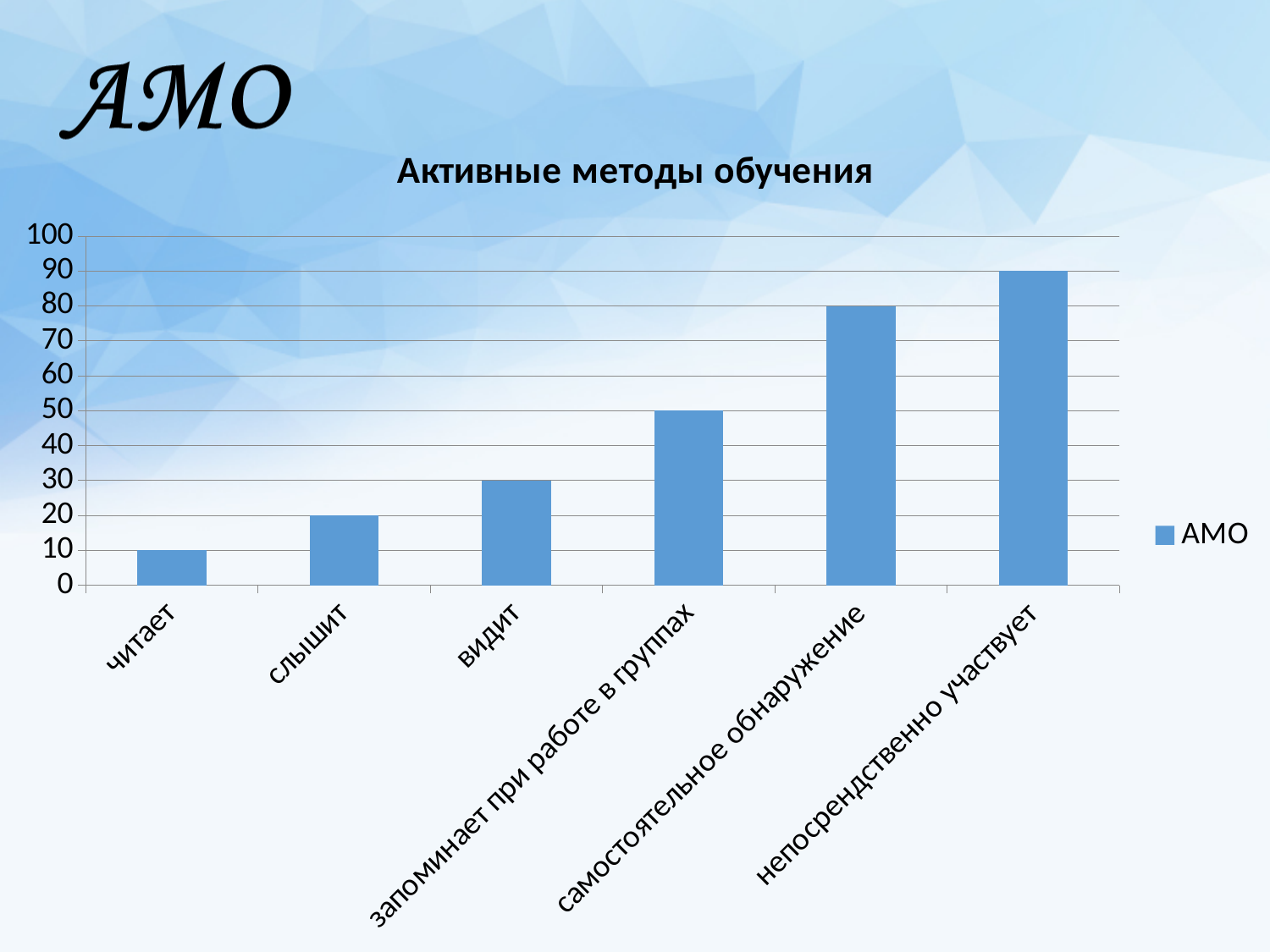
Which category has the highest value? непосрендственно участвует What is the value for "видит"? 30 Do the values rise or fall from left to right along the x axis? rise How many series does the legend list? 1 What is the title of the chart? Активные методы обучения What is the difference between the values for "непосрендственно участвует" and "запоминает при работе в группах"? 40 How many categories are shown on the x axis? 6 What type of chart is shown on the slide? bar chart What is the value for "самостоятельное обнаружение"? 80 Which is larger, the value for "слышит" or the value for "видит"? видит What is the value for "читает"? 10 Which category has the lowest value? читает